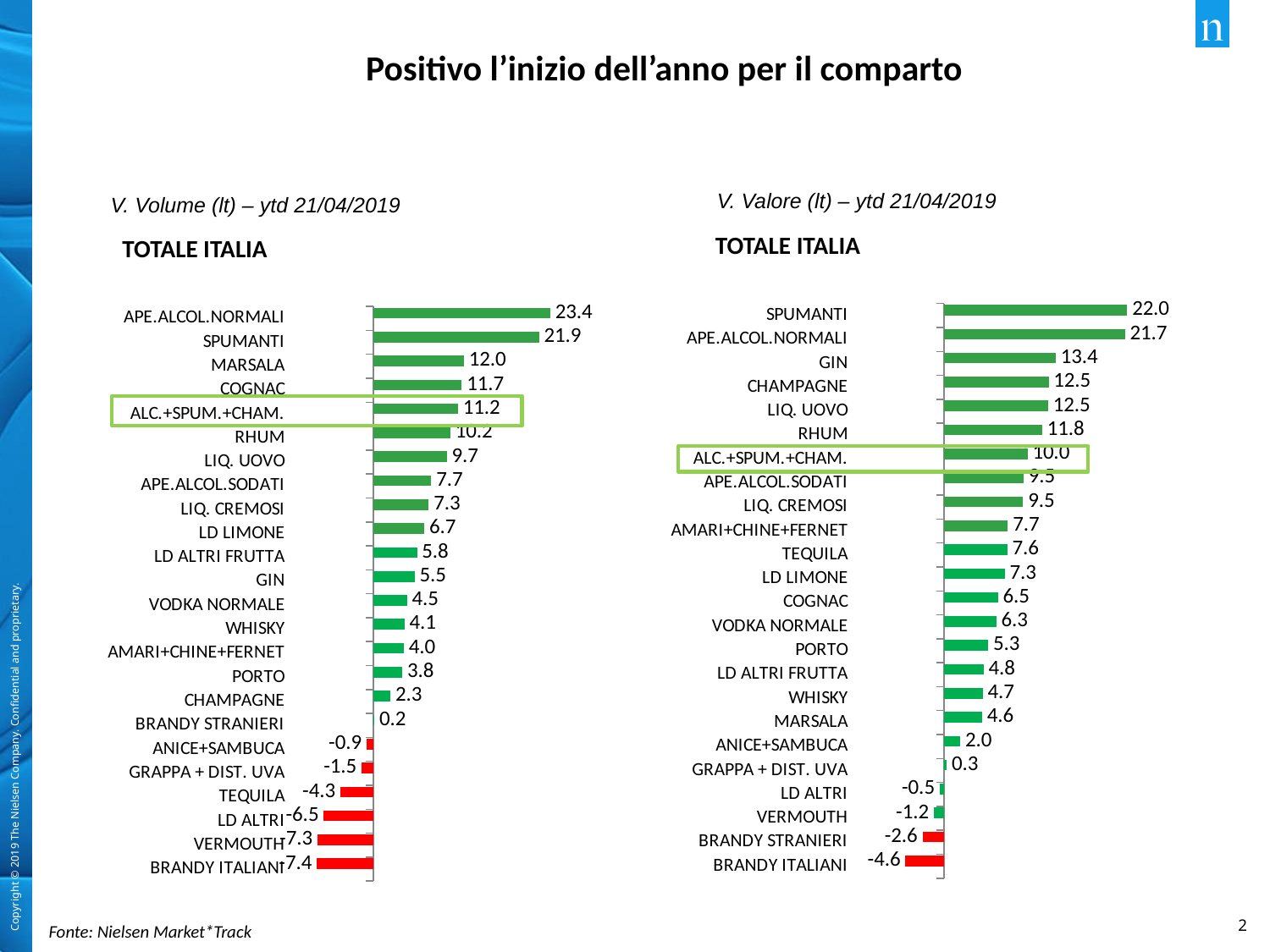
In the Valore chart (right), which category has the highest value? SPUMANTI In the Volume chart (left), what is the value for TEQUILA? -4.3 In the Valore chart (right), what is the value for GIN? 13.4 In the Volume chart (left), which category has the highest value? APE.ALCOL.NORMALI In the Valore chart (right), which category has the lowest value? BRANDY ITALIANI In the Volume chart (left), what is the value for APE.ALCOL.NORMALI? 23.4 In the Valore chart (right), what is the difference between SPUMANTI and APE.ALCOL.NORMALI? 0.3 In the Volume chart (left), what is the difference between MARSALA and COGNAC? 0.3 In the Volume chart (left), what is the value for ALC.+SPUM.+CHAM.? 11.2 In the Valore chart (right), which is larger, the value for TEQUILA or the value for COGNAC? TEQUILA What type of chart is the Volume chart (left)? Bar chart How many categories are shown in the Valore chart (right)? 24